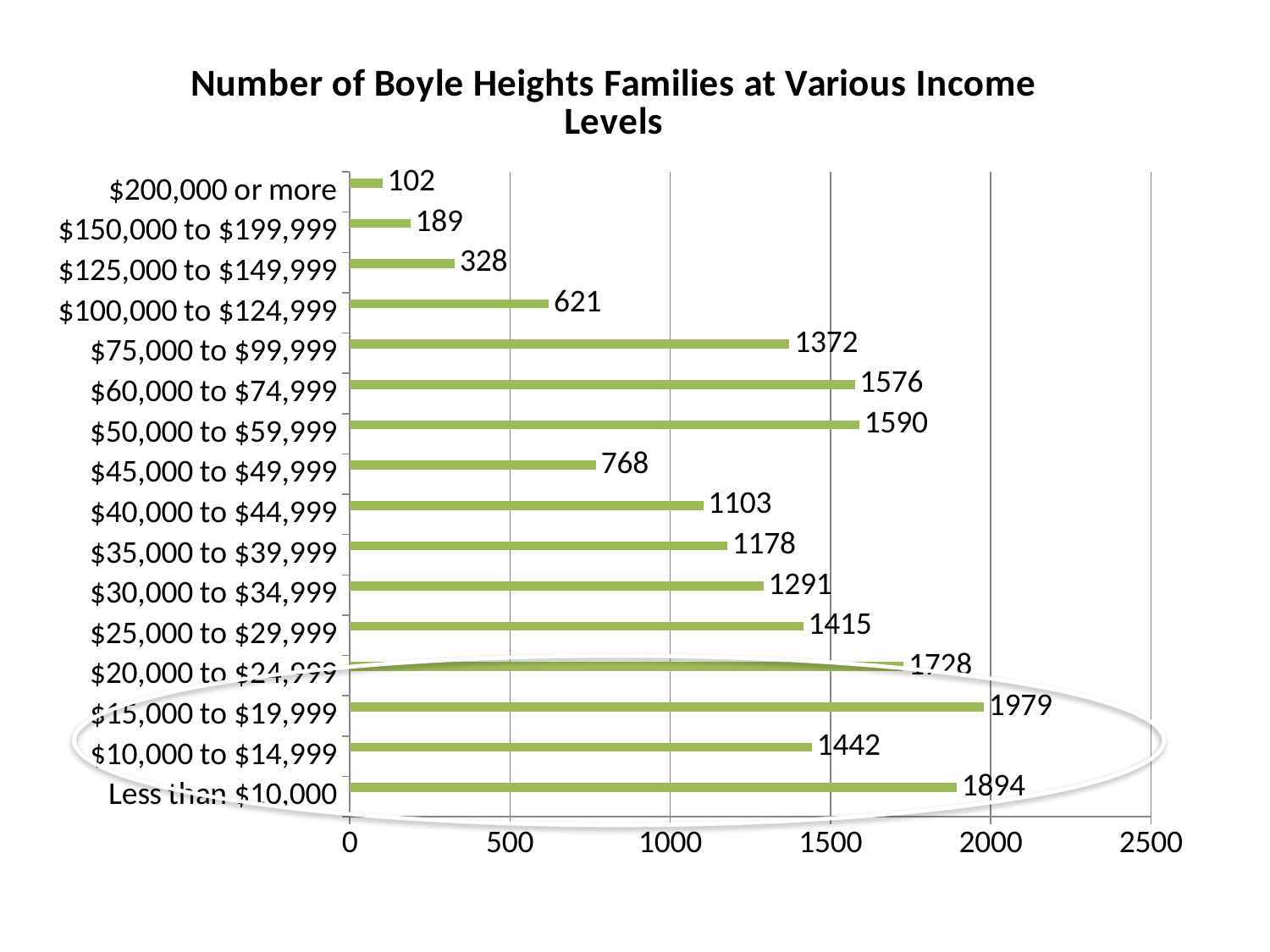
What is the difference between the number of families in the $125,000 to $149,999 level and the $150,000 to $199,999 level? 139 What type of chart is shown on the slide? bar chart How many income levels are shown on the chart? 16 What is the difference between the number of families in the $15,000 to $19,999 level and the $10,000 to $14,999 level? 537 How many families are in the $100,000 to $124,999 income level? 621 Which has more families: the $60,000 to $74,999 level or the $45,000 to $49,999 level? $60,000 to $74,999 How many families are in the Less than $10,000 income level? 1894 How many families are in the $50,000 to $59,999 income level? 1590 Which income level has the highest number of families? $15,000 to $19,999 Is the value for $75,000 to $99,999 greater or less than 1500? less Which income level has the lowest number of families? $200,000 or more What is the title of the chart? Number of Boyle Heights Families at Various Income Levels